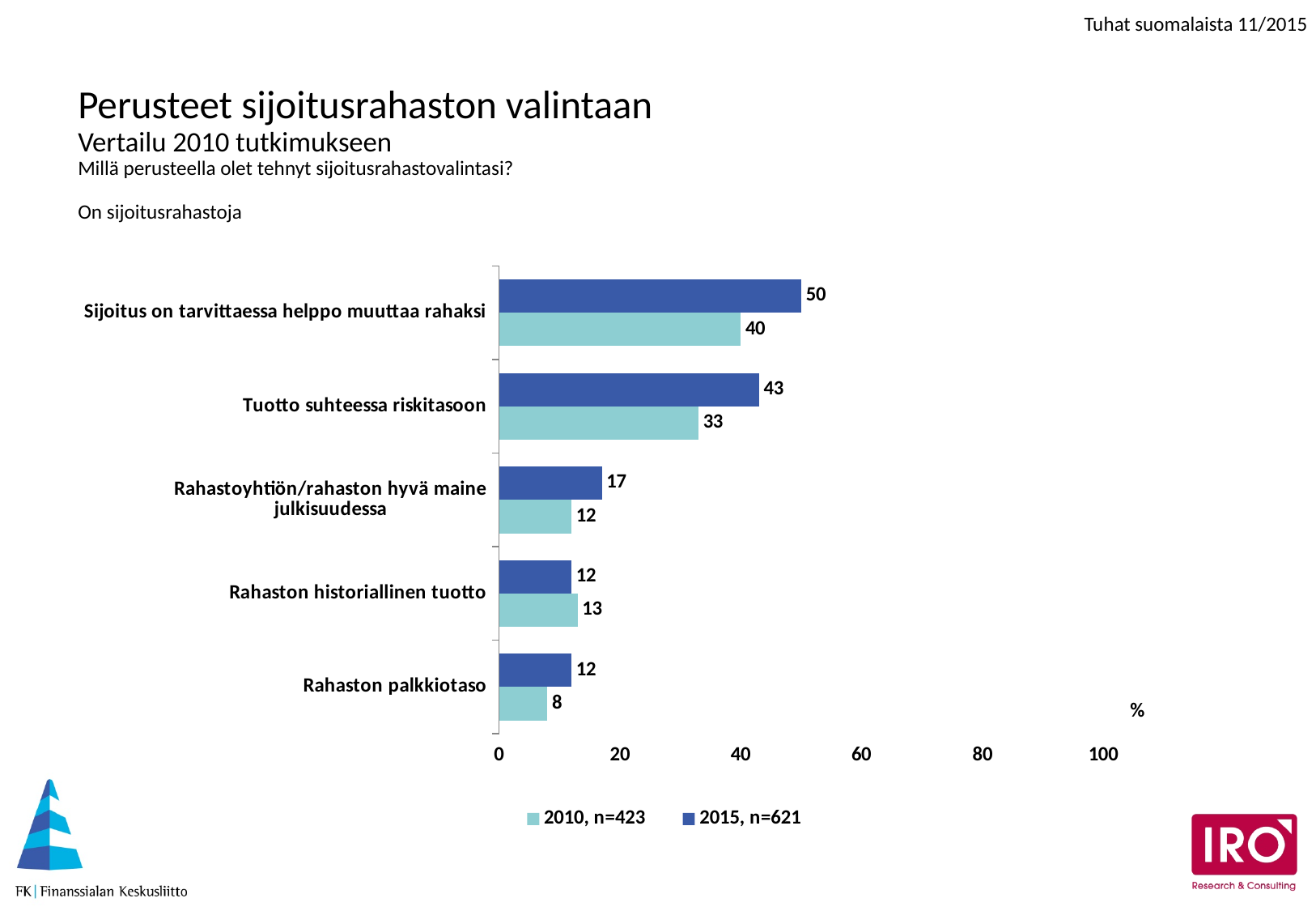
What is the 2010 value for "Tuotto suhteessa riskitasoon"? 33 What is the sample size (n) for the 2015 series according to the legend? 621 Which category has the lowest 2010 value? Rahaston palkkiotaso What is the 2015 value for "Sijoitus on tarvittaessa helppo muuttaa rahaksi"? 50 What is the difference between the 2015 and 2010 values for "Sijoitus on tarvittaessa helppo muuttaa rahaksi"? 10 What is the difference between the 2015 and 2010 values for "Tuotto suhteessa riskitasoon"? 10 What is the 2010 value for "Rahaston palkkiotaso"? 8 How many categories are shown in the chart? 5 Which category has the highest 2015 value? Sijoitus on tarvittaessa helppo muuttaa rahaksi For "Rahaston historiallinen tuotto", which year has the larger value, 2010 or 2015? 2010 How many series does the legend list? 2 What kind of chart is shown on the slide? Bar chart